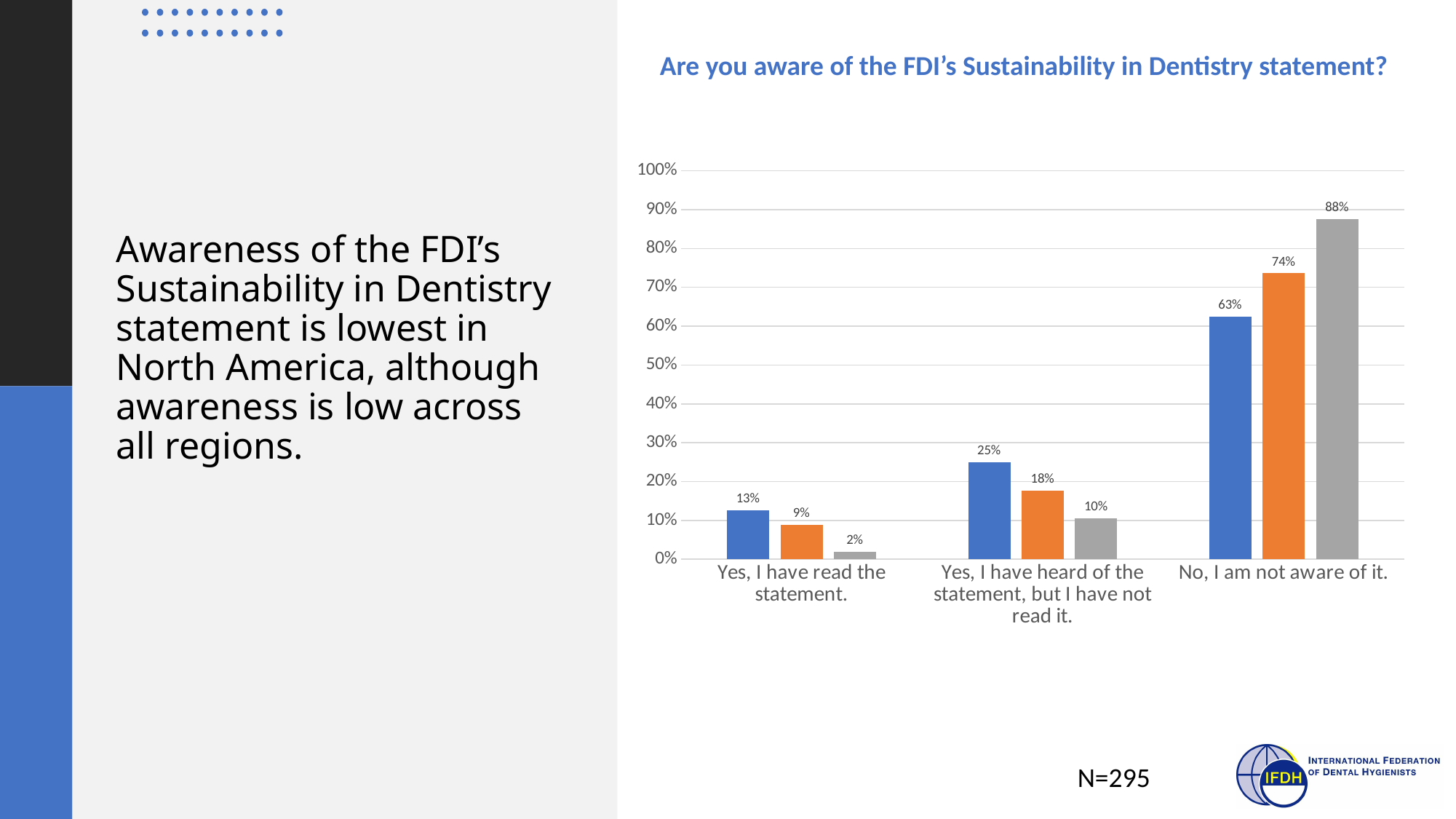
Which bar has the lowest value in the whole chart? The grey bar for "Yes, I have read the statement." (2%) What is the difference between the grey bar and the blue bar for "No, I am not aware of it."? 25% Which response category has the highest values across all bars? No, I am not aware of it. Is the value of the orange bar for "No, I am not aware of it." greater or less than 70%? greater For "Yes, I have heard of the statement, but I have not read it.", which is larger: the blue bar or the grey bar? the blue bar What sample size (N) is shown on the slide? N=295 What is the value of the orange bar for "Yes, I have heard of the statement, but I have not read it."? 18% What is the value of the blue bar for "Yes, I have read the statement."? 13% How many response categories are shown on the x axis of the chart? 3 What kind of chart is shown on the slide? bar chart What is the title of the chart? Are you aware of the FDI's Sustainability in Dentistry statement? What is the value of the grey bar for "No, I am not aware of it."? 88%